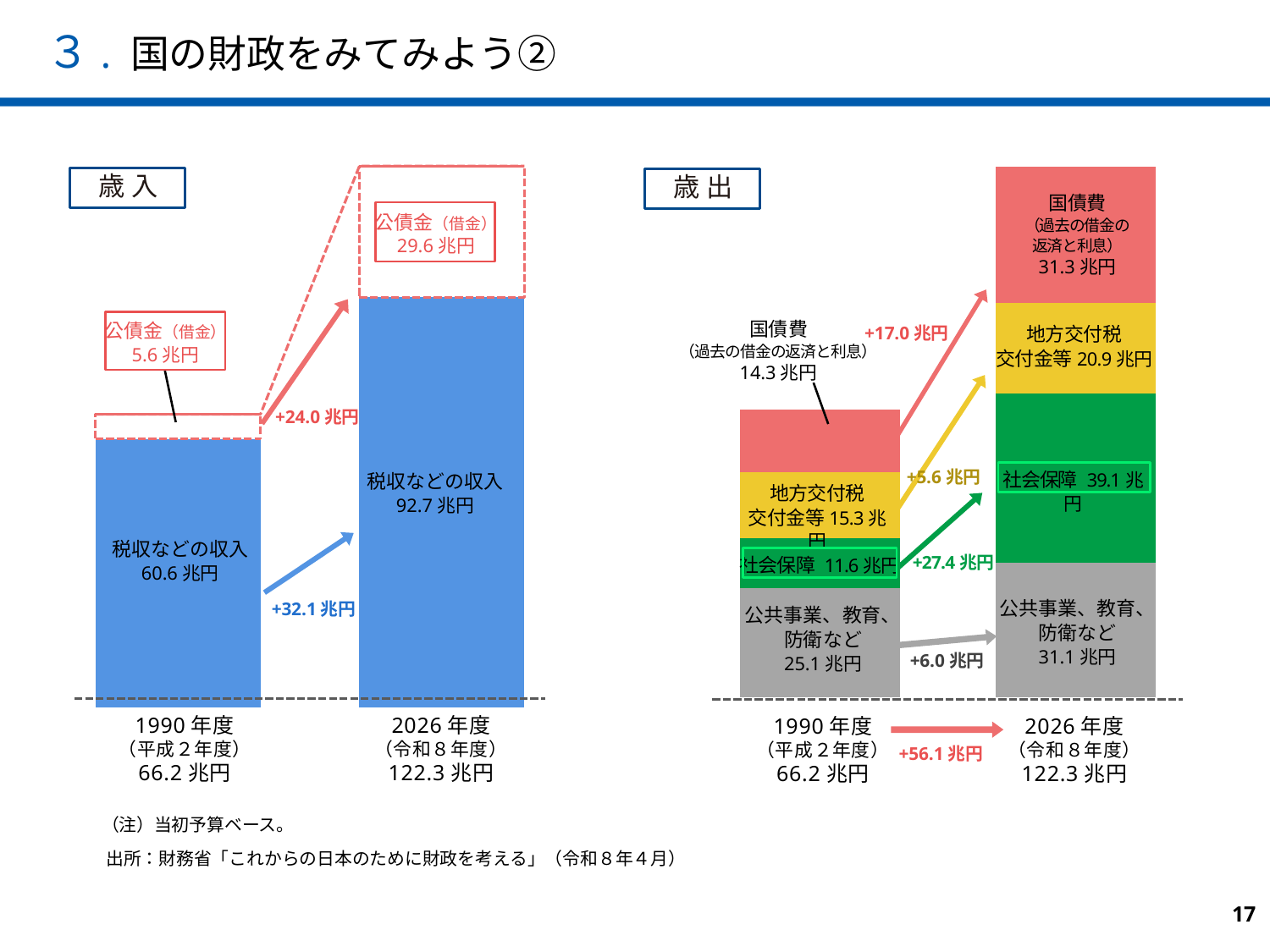
歳出のグラフで、2026年度に最も金額が大きい項目はどれですか？ 社会保障 歳出のグラフは、各年度の棒をいくつの項目に分けて示していますか？ 4 歳出のグラフで、2026年度の「社会保障」はいくらですか？ 39.1兆円 歳出のグラフで、1990年度に最も金額が小さい項目はどれですか？ 社会保障 歳入のグラフで、1990年度の「公債金（借金）」はいくらですか？ 5.6兆円 歳入のグラフで、2026年度の「税収などの収入」はいくらですか？ 92.7兆円 歳出のグラフで、2026年度の「国債費」と「地方交付税交付金等」ではどちらが大きいですか？ 国債費 歳入のグラフで、1990年度から2026年度にかけて「公債金（借金）」はいくら増えましたか？ +24.0兆円 歳出のグラフで、1990年度から2026年度にかけて「社会保障」はいくら増えましたか？ +27.4兆円 歳出のグラフで、1990年度の歳出合計はいくらですか？ 66.2兆円 歳入のグラフで、2026年度の歳入合計はいくらですか？ 122.3兆円 歳出のグラフで、1990年度の「国債費」はいくらですか？ 14.3兆円